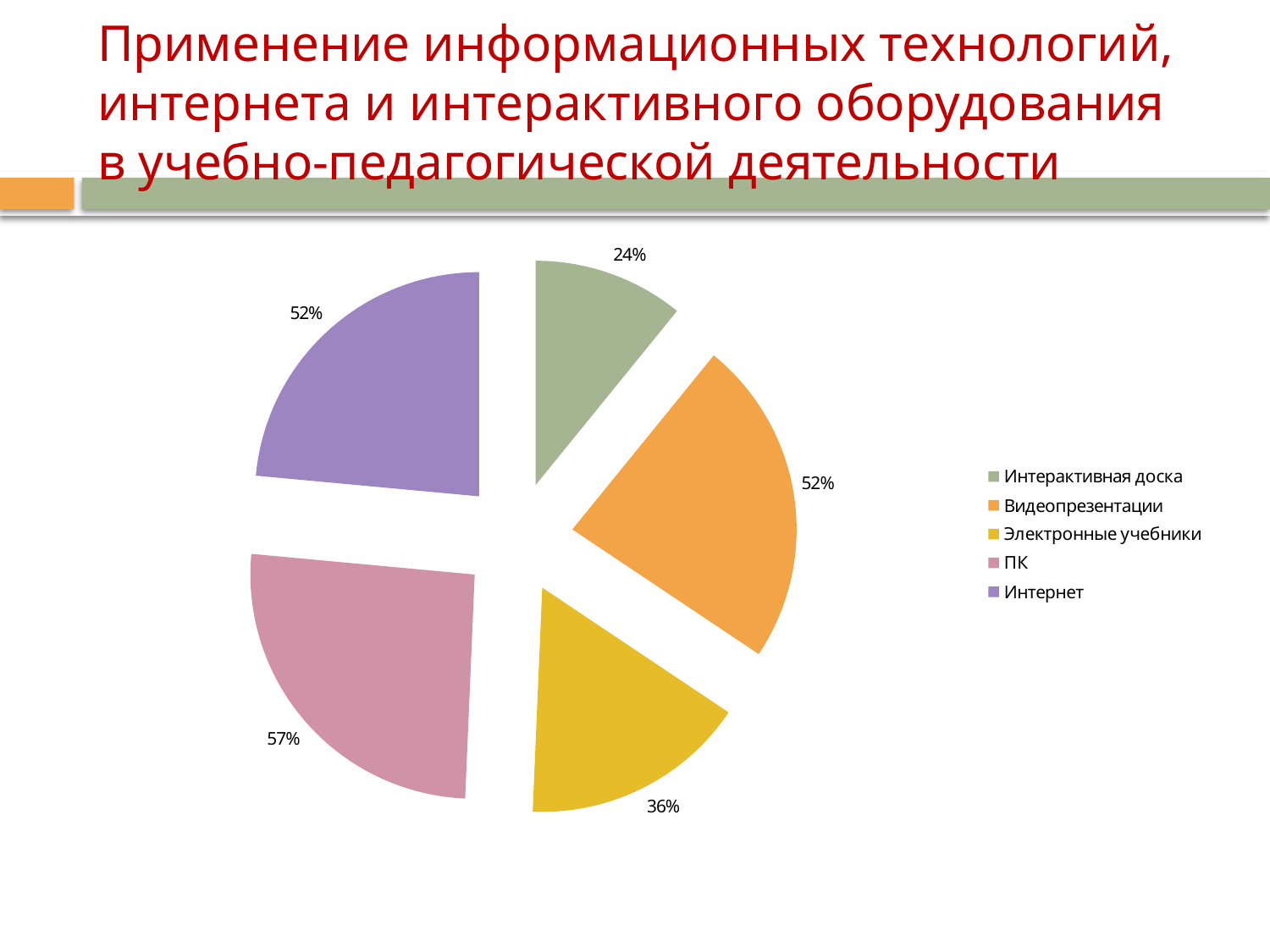
What kind of chart is shown on the slide? pie chart What value is shown for Электронные учебники? 36% What colour is the slice for Интернет? purple Which category has the largest slice? ПК What value is shown for ПК? 57% How many slices does the pie chart have? 5 Which category has the smallest slice? Интерактивная доска What value is shown for Интерактивная доска? 24% How many entries does the legend list? 5 What value is shown for Интернет? 52% What value is shown for Видеопрезентации? 52% Which is larger, the value for ПК or the value for Электронные учебники? ПК